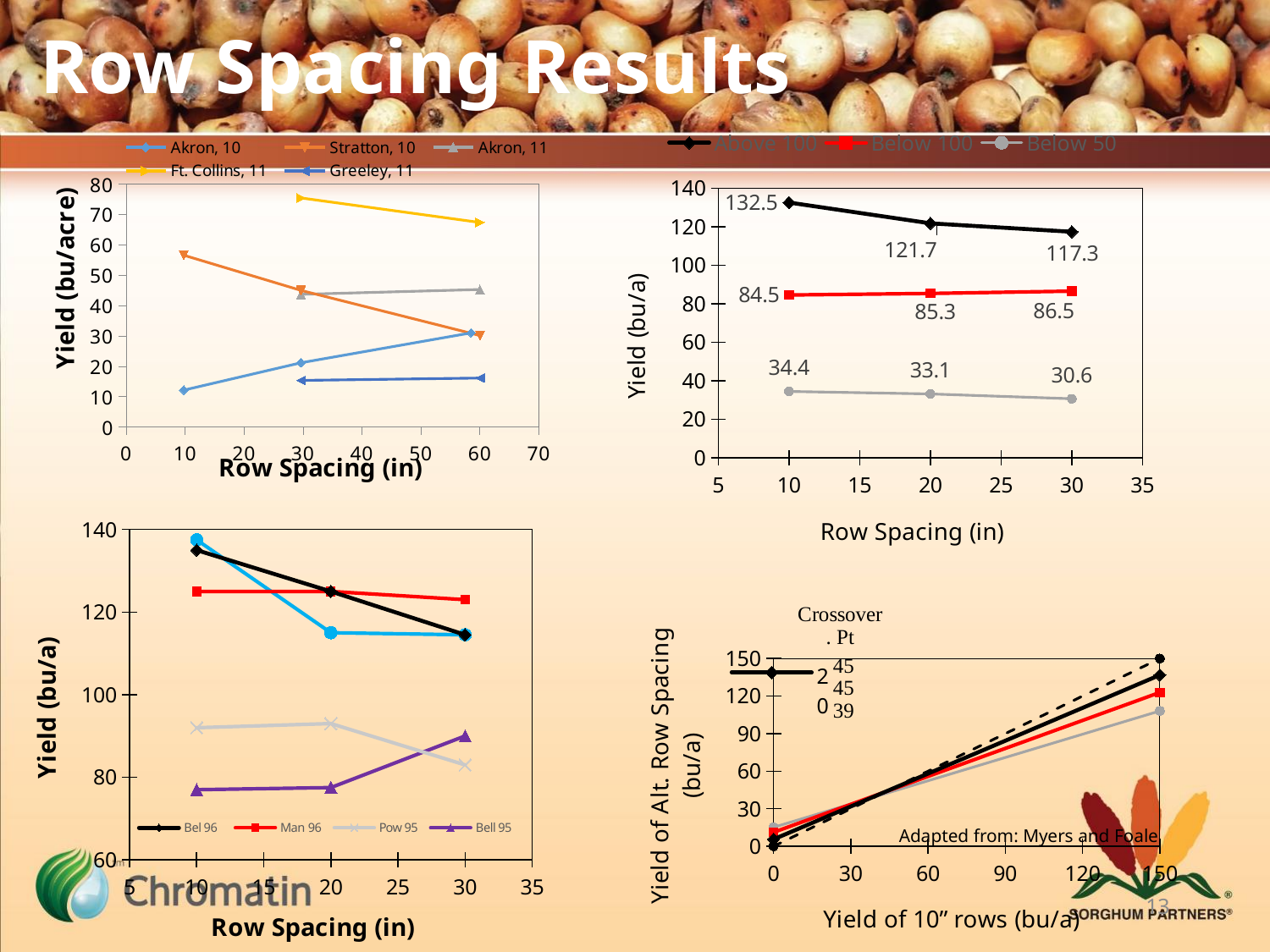
In the bottom-left chart, is the value for Bell 95 at a row spacing of 10 in greater or less than 80? less In the top-right chart, what is the yield for the Below 50 series at a row spacing of 30 in? 30.6 In the top-left chart, is the value for Ft. Collins, 11 at a row spacing of 30 in greater or less than 70? greater In the top-right chart, does the Above 100 series rise or fall as row spacing increases? fall In the top-right chart, what is the yield for the Below 100 series at a row spacing of 20 in? 85.3 How many series does the legend of the top-right chart list? 3 In the top-right chart, what is the difference between the Above 100 yield at 10 in and at 30 in? 15.2 In the top-right chart, what is the yield for the Above 100 series at a row spacing of 10 in? 132.5 What kind of chart is the bottom-left chart? line chart In the top-right chart, does the Below 100 series rise or fall as row spacing increases? rise In the top-left chart, at a row spacing of 10 in, which series has the larger yield, Stratton, 10 or Akron, 10? Stratton, 10 How many series does the legend of the top-left chart list? 5